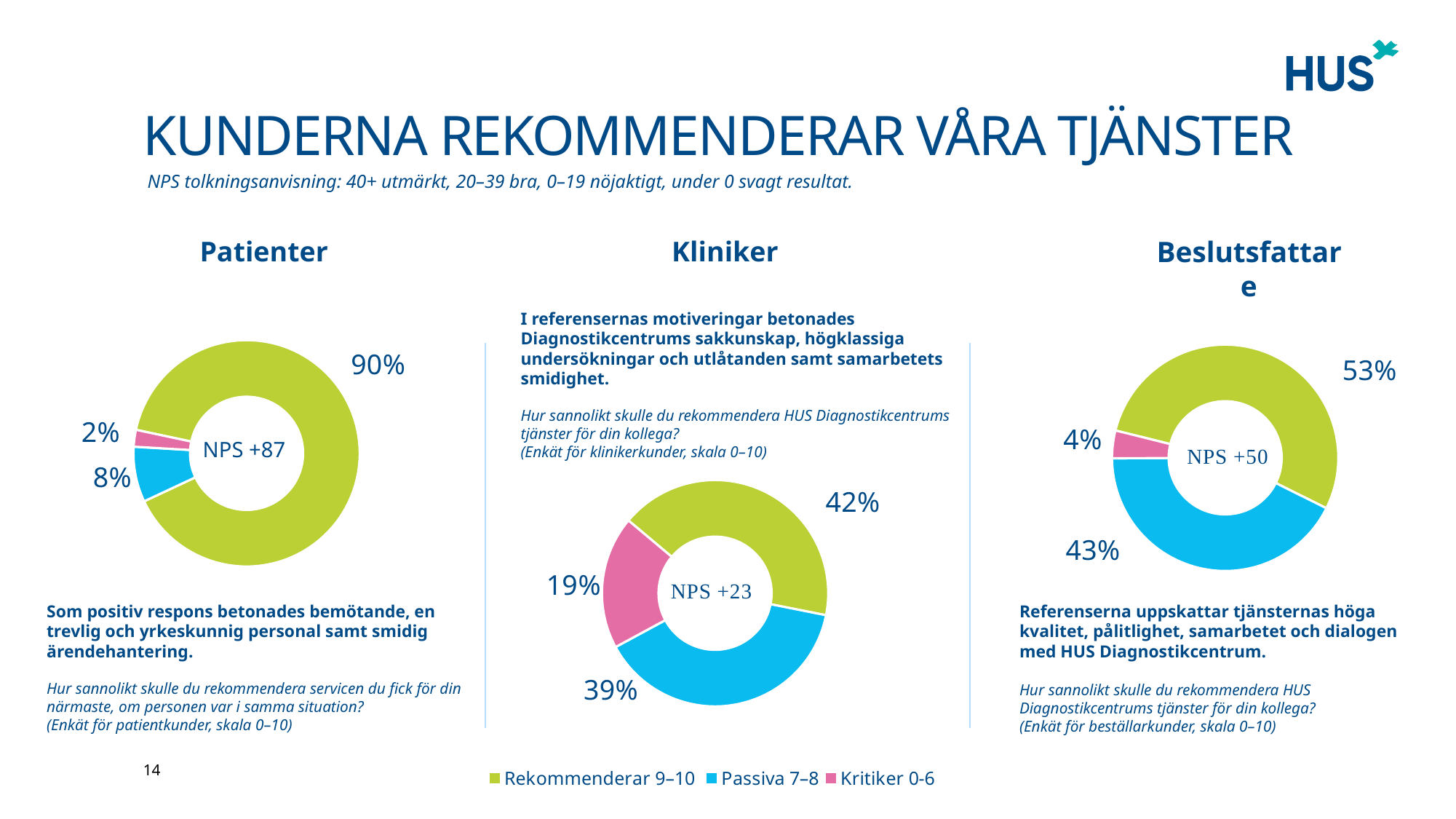
In the Kliniker chart, which category has the smallest share? Kritiker 0-6 What kind of chart is used for the Patienter data? Doughnut chart What NPS value is shown in the centre of the Kliniker chart? NPS +23 In the Kliniker chart, what share is Passiva 7–8? 39% In the Beslutsfattare chart, which category has the largest share? Rekommenderar 9–10 In the Kliniker chart, which is larger: Rekommenderar 9–10 or Passiva 7–8? Rekommenderar 9–10 In the Patienter chart, what share is Rekommenderar 9–10? 90% In the Patienter chart, what share is Kritiker 0-6? 2% In the Patienter chart, what is the difference between the Rekommenderar 9–10 share and the Passiva 7–8 share? 82 percentage points How many categories does the legend list? 3 In the Beslutsfattare chart, what share is Rekommenderar 9–10? 53% Which colour represents Passiva 7–8 in the charts? Blue